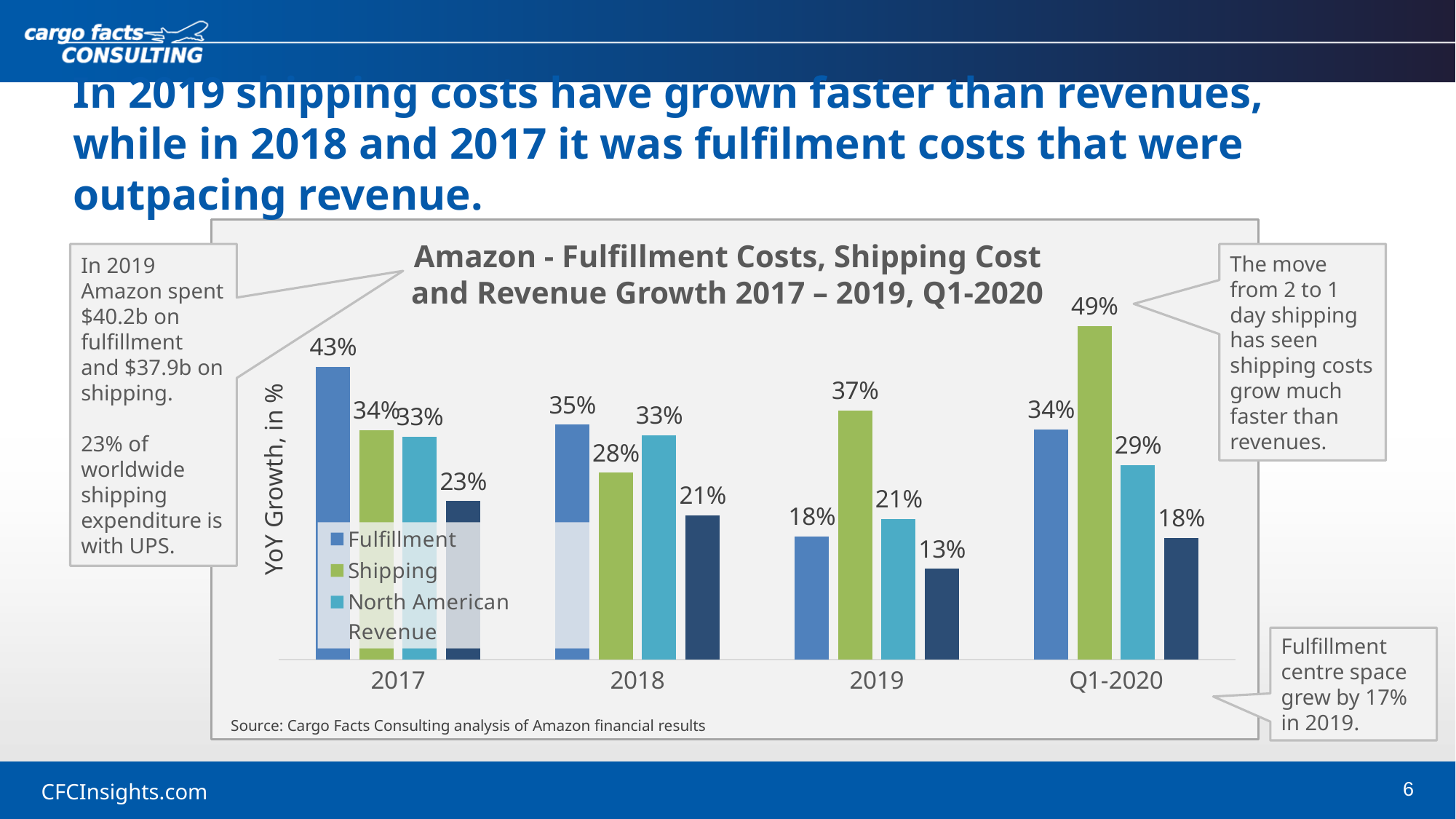
What is the label on the y axis of the chart? YoY Growth, in % What is the title of the chart? Amazon - Fulfillment Costs, Shipping Cost and Revenue Growth 2017 – 2019, Q1-2020 What is the difference between Shipping growth and Fulfillment growth in 2019? 19% In which period was Shipping growth highest? Q1-2020 Which was larger in 2018, Fulfillment growth or Shipping growth? Fulfillment How many time periods are shown on the x axis? 4 What was the Shipping growth in Q1-2020? 49% In which period was Fulfillment growth lowest? 2019 What was the Fulfillment growth in 2019? 18% What was the Fulfillment growth in 2017? 43% What type of chart is shown on the slide? bar chart What was the North American Revenue growth in 2018? 33%